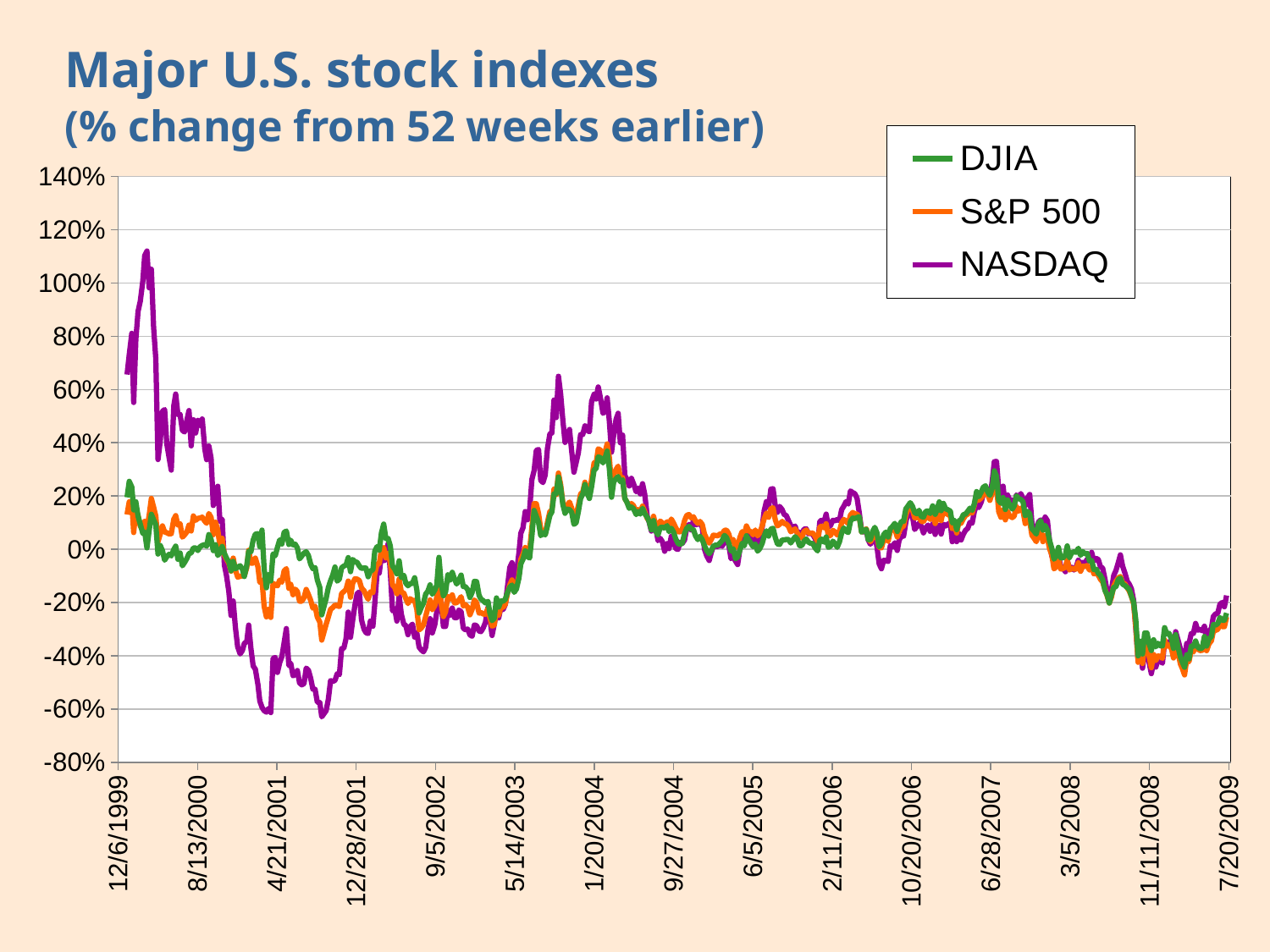
Is the peak value for NASDAQ in early 2000 greater or less than 100%? greater Which series reaches the lowest value on the chart? NASDAQ How many series does the legend list? 3 Which series reaches the highest value on the chart? NASDAQ Is the value for DJIA around 11/11/2008 greater or less than -20%? less What kind of chart is shown on the slide? line chart Is the lowest value for NASDAQ in 2001 greater or less than -40%? less Do the values for all three indexes rise or fall between 6/28/2007 and 11/11/2008? fall At 12/6/1999, which is larger, the value for NASDAQ or the value for DJIA? NASDAQ What is the title of the chart? Major U.S. stock indexes (% change from 52 weeks earlier) How many date labels are shown on the x axis? 15 Which series is drawn in purple? NASDAQ